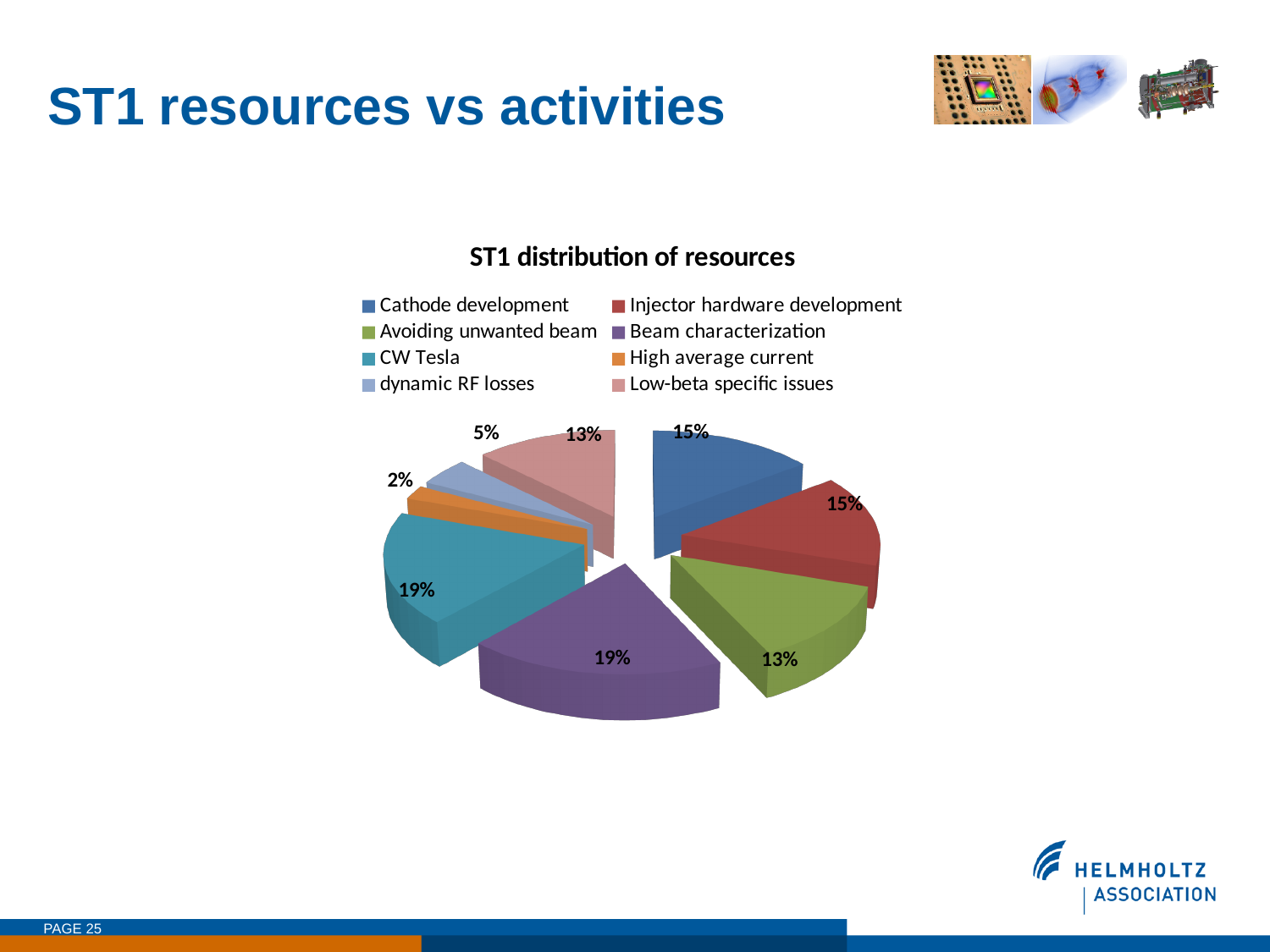
Which category has the smallest share of the pie? High average current How many percentage points larger is the CW Tesla share than the dynamic RF losses share? 14 percentage points What percentage of the pie is Beam characterization? 19% Which is larger: the share for Injector hardware development or the share for Avoiding unwanted beam? Injector hardware development What is the title of the chart? ST1 distribution of resources What percentage is shown for dynamic RF losses? 5% What share of resources is allocated to Low-beta specific issues? 13% What share does High average current receive? 2% How many categories does the pie chart contain? 8 What type of chart is shown on the slide? Pie chart Which legend entry is shown in purple? Beam characterization What share of ST1 resources goes to Cathode development? 15%